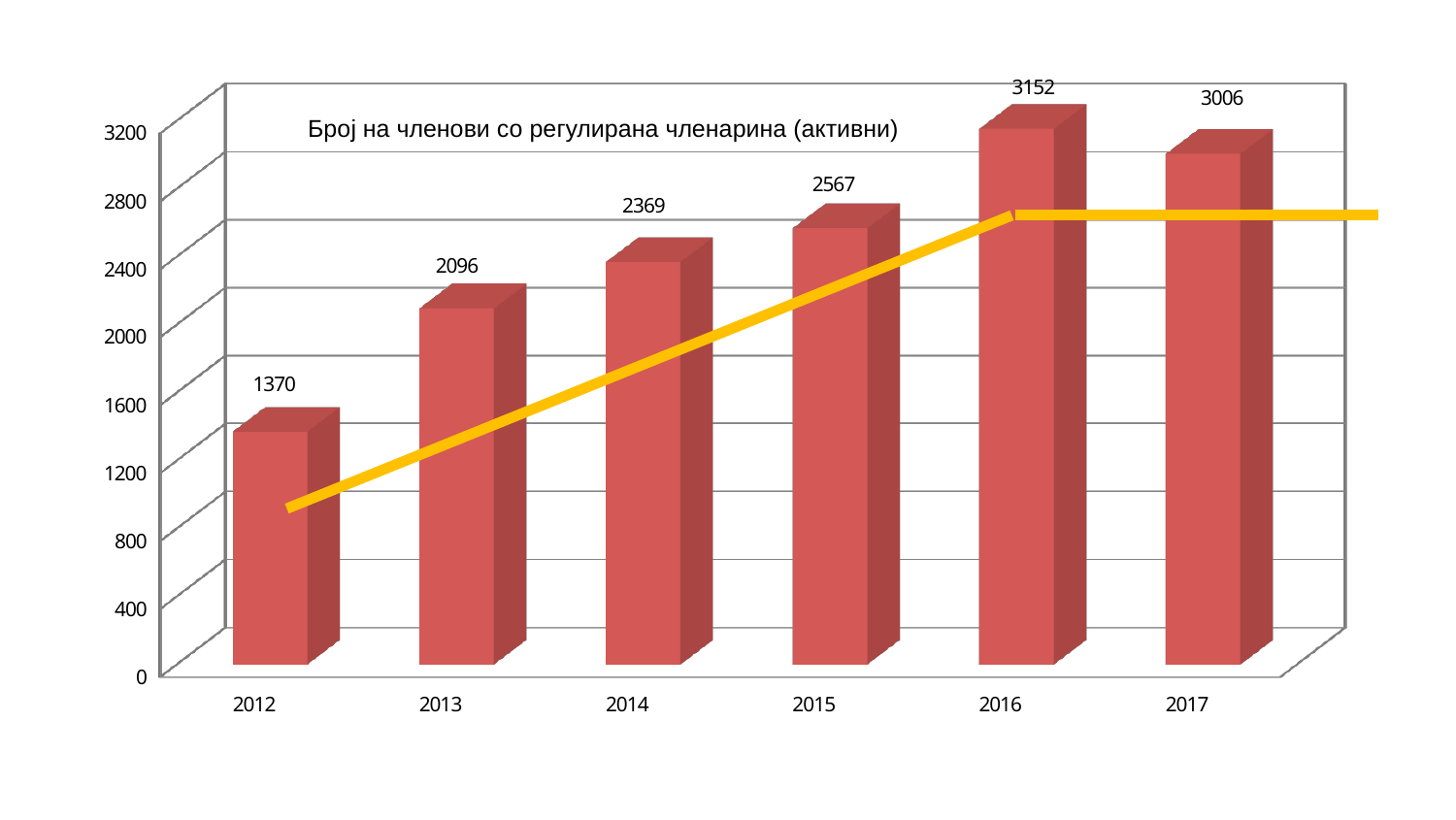
What is the value for 2012? 1370 Which year has the highest value? 2016 What is the value for 2015? 2567 What kind of chart is this? bar chart What is the title of the chart? Број на членови со регулирана членарина (активни) What is the difference between the values for 2013 and 2012? 726 Is the value for 2013 greater or less than 2000? greater What is the difference between the values for 2016 and 2017? 146 What is the value for 2017? 3006 Which year has the lowest value? 2012 Which is larger, the value for 2014 or the value for 2015? 2015 How many years are shown on the x axis? 6